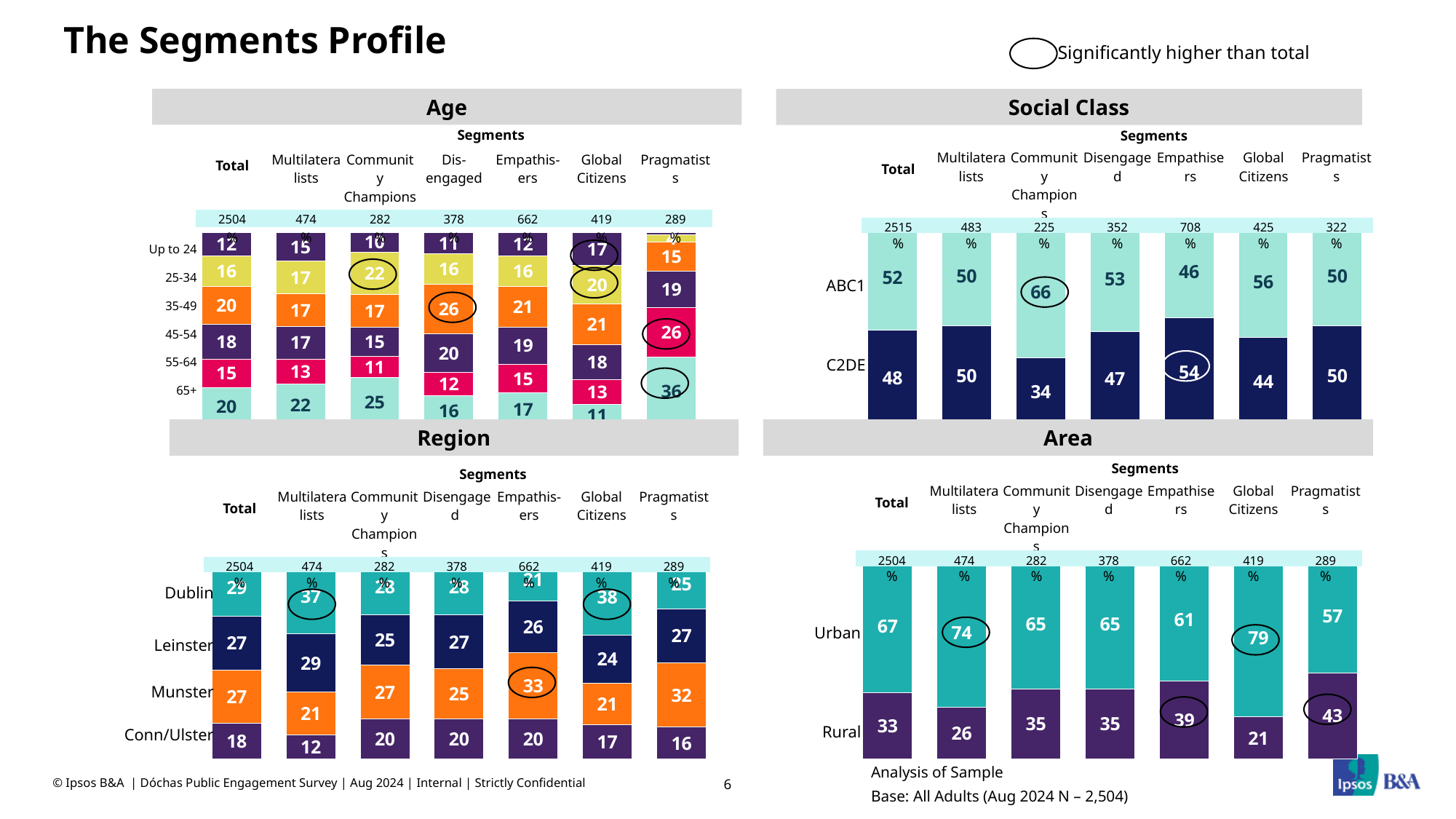
In the Social Class chart, what is the ABC1 value for Community Champions? 66 In the Area chart, what is the Urban value for Global Citizens? 79 In the Region chart, what is the Munster value for Empathisers? 33 What kind of chart is the Social Class chart? Stacked bar chart In the Social Class chart, which segment has the highest ABC1 value? Community Champions In the Area chart, which segment has the highest Rural value? Pragmatists In the Age chart, what is the 65+ value for Community Champions? 25 In the Region chart, is the Dublin value larger for Multilateralists or for Global Citizens? Global Citizens In the Area chart, what is the difference between the Urban values for Multilateralists and Pragmatists? 17 In the Social Class chart, what is the C2DE value for Empathisers? 54 In the Age chart, what is the 35-49 value for Disengaged? 26 In the Region chart, which segment has the lowest Conn/Ulster value? Multilateralists